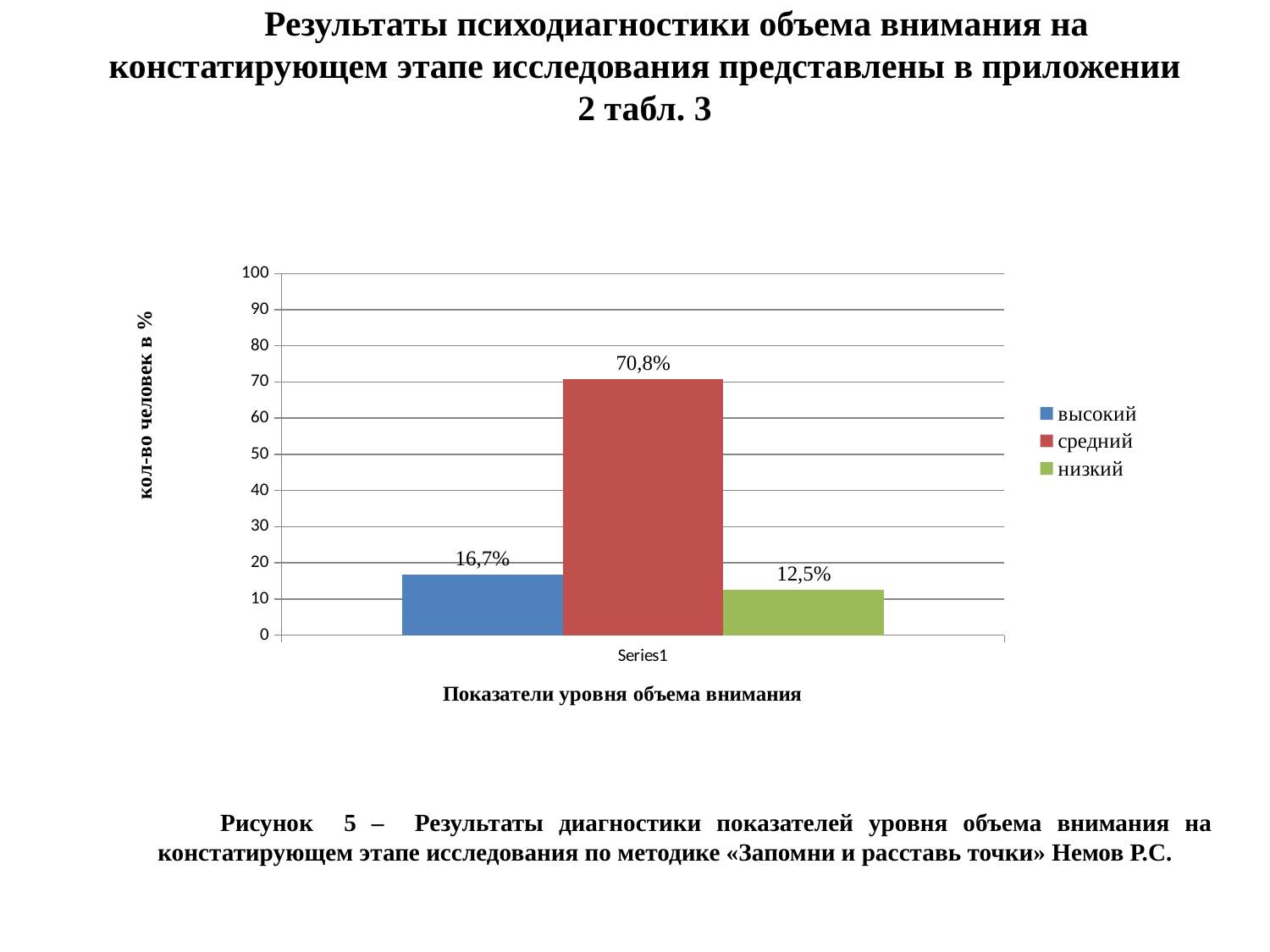
What is the value for the 'высокий' level? 16,7% What is the label of the vertical axis? кол-во человек в % What is the difference between the 'высокий' and 'низкий' values? 4,2% Which is larger, the value for 'высокий' or for 'низкий'? высокий How many series does the legend list? 3 What is the value for the 'средний' level? 70,8% What is the value for the 'низкий' level? 12,5% Which level has the lowest value? низкий Is the value for 'средний' greater or less than 60? greater What kind of chart is shown on the slide? bar chart Which level has the highest value? средний What is the difference between the 'средний' and 'высокий' values? 54,1%